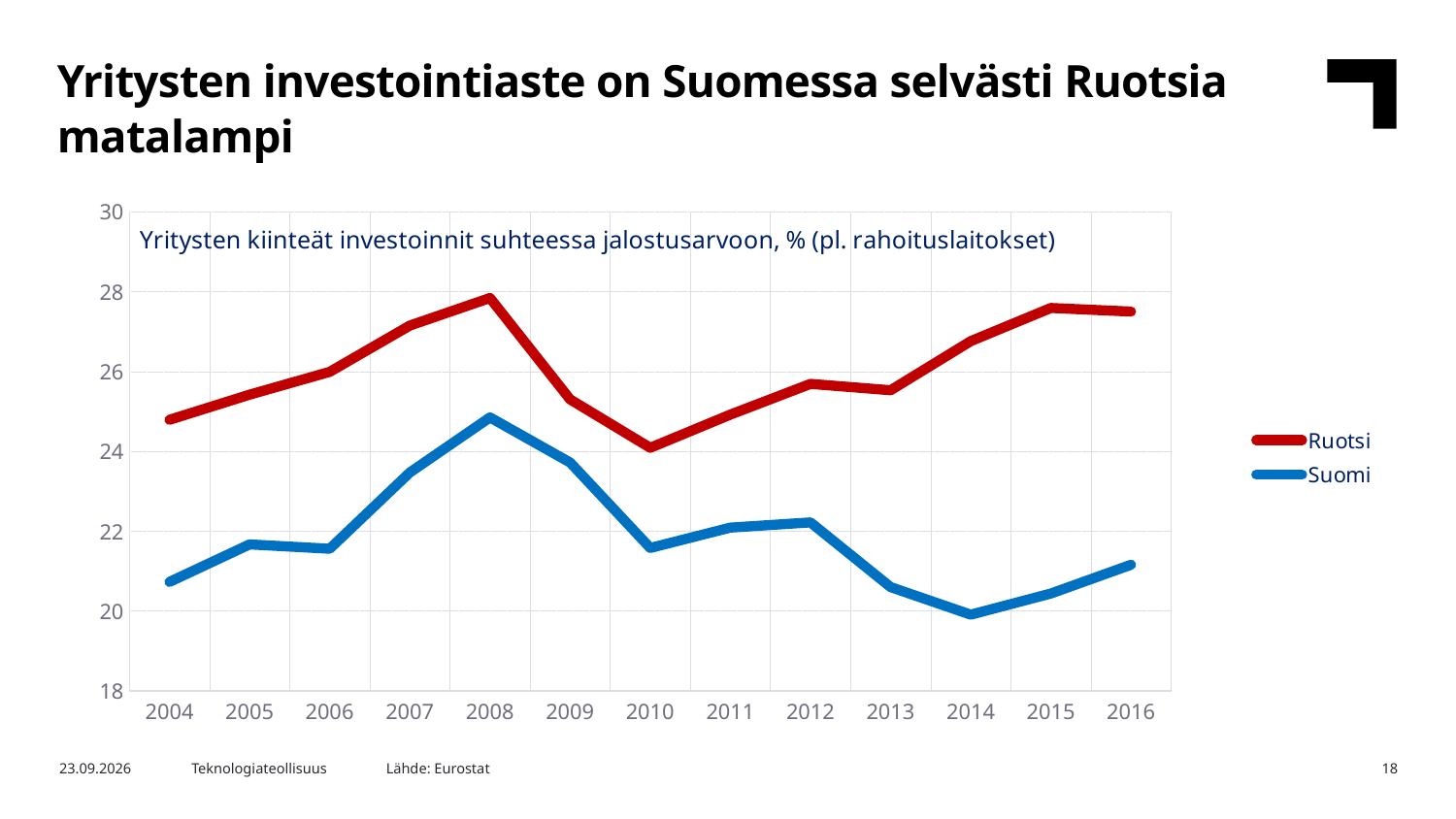
Is the value for Suomi in 2008 greater or less than 24? greater Which series has the higher value in 2016, Ruotsi or Suomi? Ruotsi Does the value for Suomi rise or fall from 2012 to 2014? fall In which year is the value for Ruotsi lowest? 2010 How many years are shown on the x axis? 13 What kind of chart is shown on the slide? line chart Is the value for Ruotsi in 2004 greater or less than 26? less In which year is the value for Suomi highest? 2008 In which year is the value for Suomi lowest? 2014 Which series is drawn in red? Ruotsi How many series does the legend list? 2